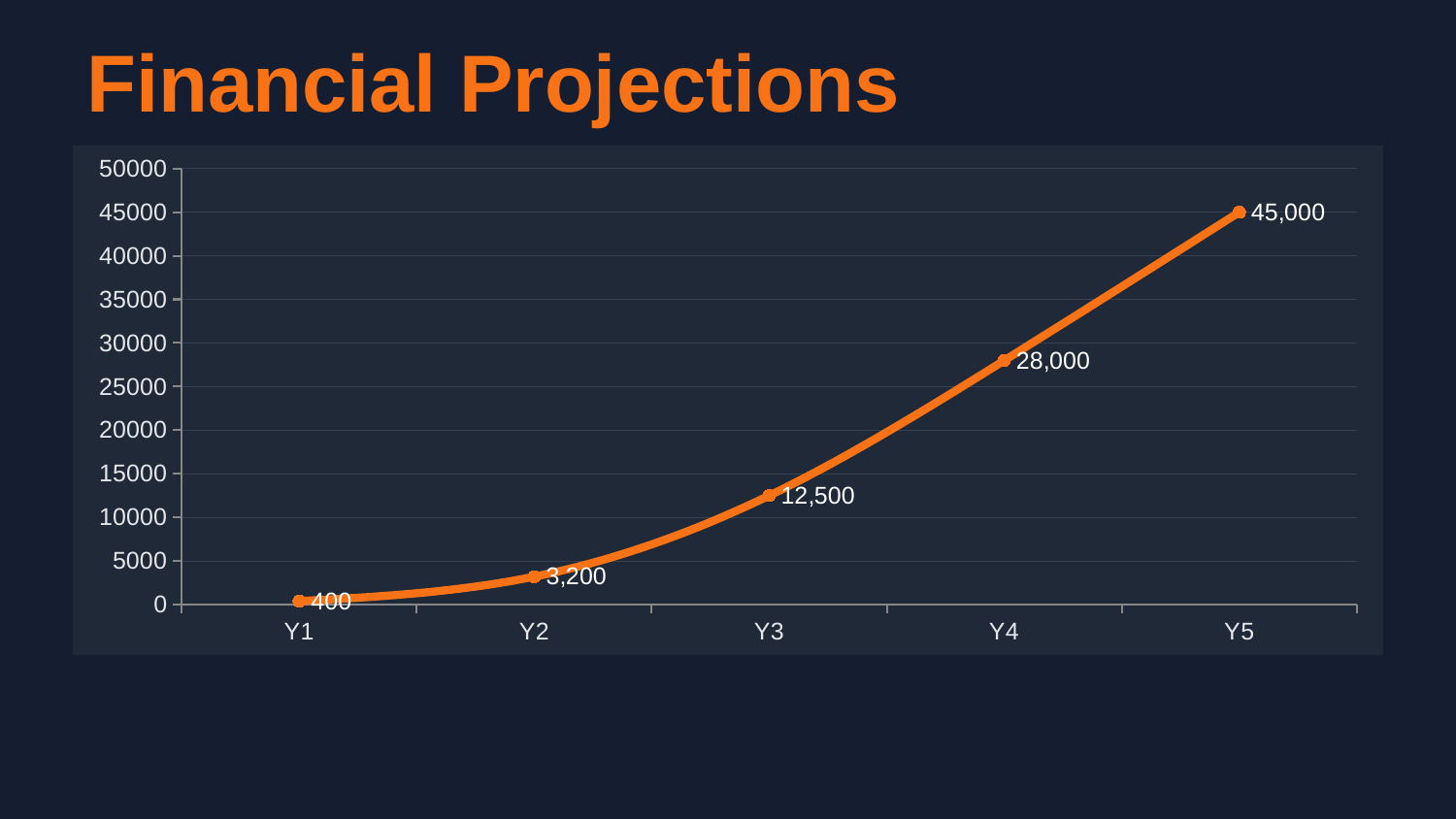
Is the value for Y4 greater or less than 25000? greater What kind of chart is shown on the slide? Line chart Do the values rise or fall from Y1 to Y5? Rise What is the value for Y5? 45,000 How many points are plotted on the chart? 5 What is the difference between the values for Y5 and Y4? 17,000 Which year has the highest value? Y5 Which is larger, the value for Y2 or the value for Y4? Y4 What is the difference between the values for Y3 and Y2? 9,300 What is the value for Y3? 12,500 What is the value for Y1? 400 Which year has the lowest value? Y1